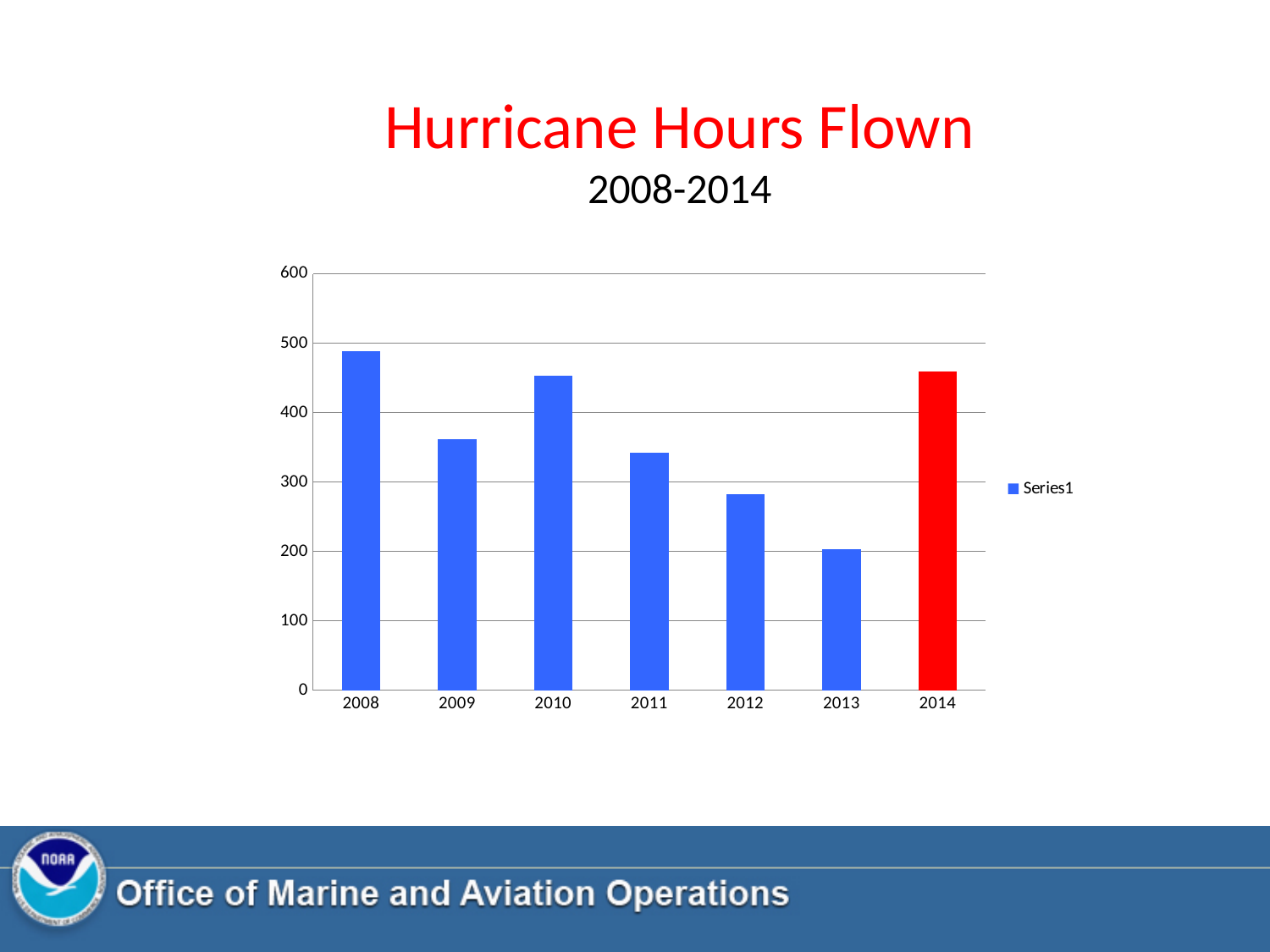
What is the title of the chart on the slide? Hurricane Hours Flown 2008-2014 Which year has the lowest hurricane hours flown? 2013 Is the value for 2013 greater or less than 300? less Which year has the highest hurricane hours flown? 2008 How many series does the legend list? 1 Do the values rise or fall from 2010 to 2013? fall How many years are shown on the x axis of the chart? 7 Is the value for 2011 greater or less than 300? greater Which year has the larger value, 2012 or 2013? 2012 Is the value for 2014 greater or less than 400? greater What kind of chart is shown on the slide? bar chart